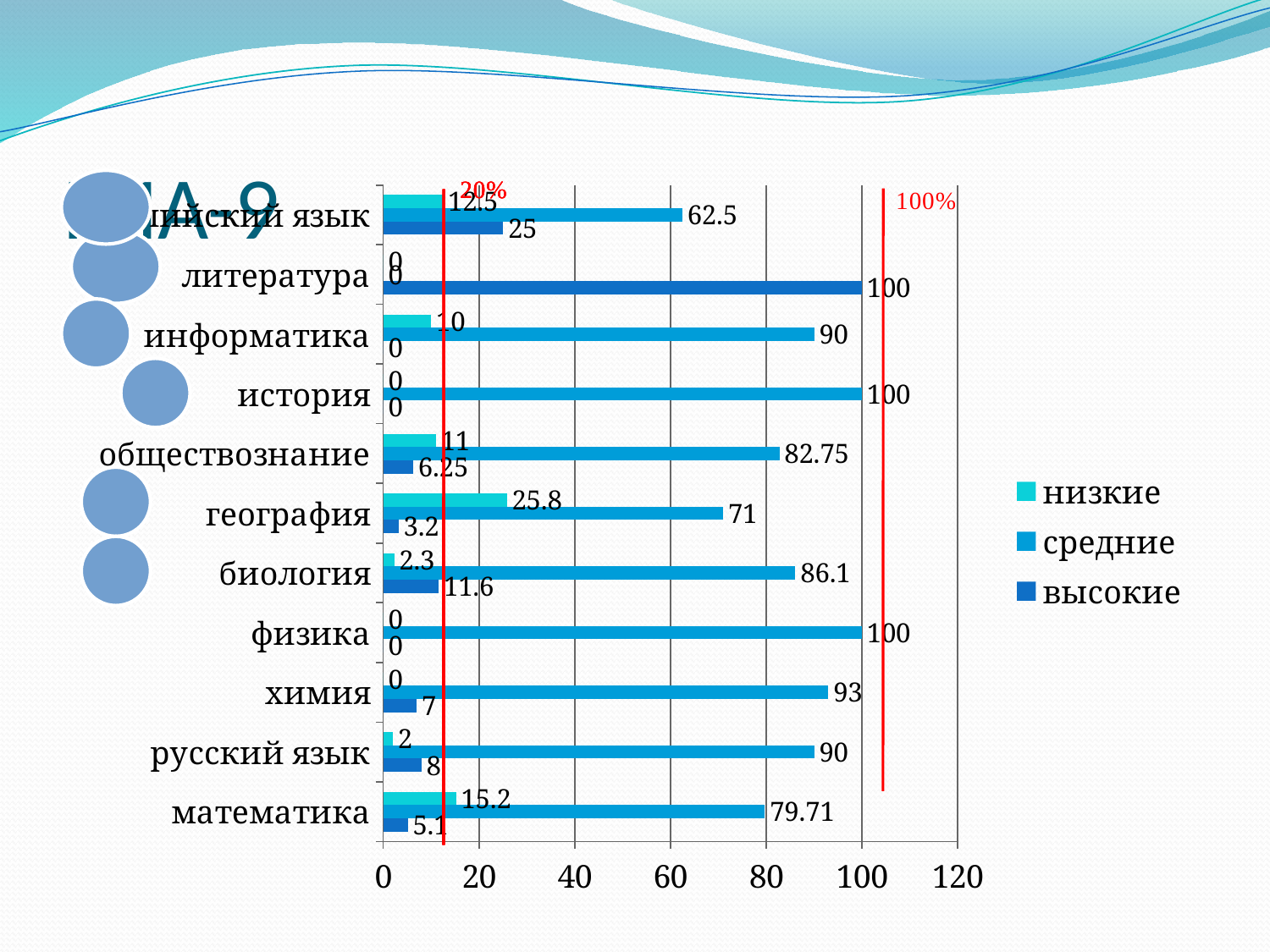
What kind of chart is shown on the slide? bar chart Which is larger, the средние value for обществознание or the средние value for география? обществознание Which category has the highest value in the низкие series? география What is the value of the средние series for математика? 79.71 What is the value of the высокие series for биология? 11.6 How many categories are shown on the chart? 11 How many series does the legend list? 3 What is the total of the three series for математика? 100.01 What are the three legend entries of the chart? низкие, средние, высокие What is the value of the низкие series for география? 25.8 What is the value of the высокие series for литература? 100 What is the difference between the средние values for химия and русский язык? 3